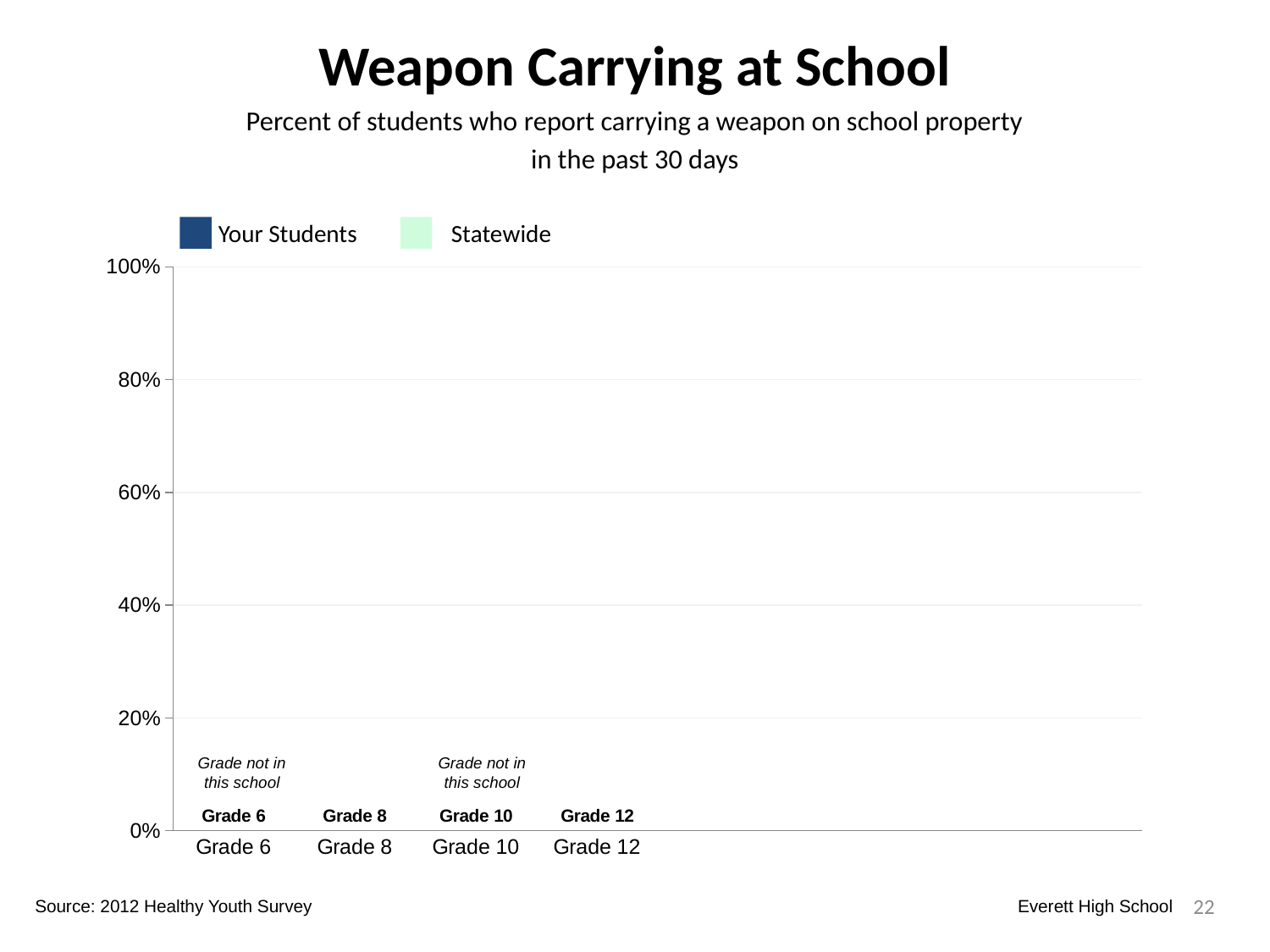
What is the title of the chart on the slide? Weapon Carrying at School What is the lowest value shown on the chart's y axis? 0% What are the two series named in the chart's legend? Your Students and Statewide How many series does the chart's legend list? 2 Which grades are marked as 'Grade not in this school' on the chart? Grade 6 and Grade 10 How many grade categories are shown along the x axis of the chart? 4 What is the highest value shown on the chart's y axis? 100%